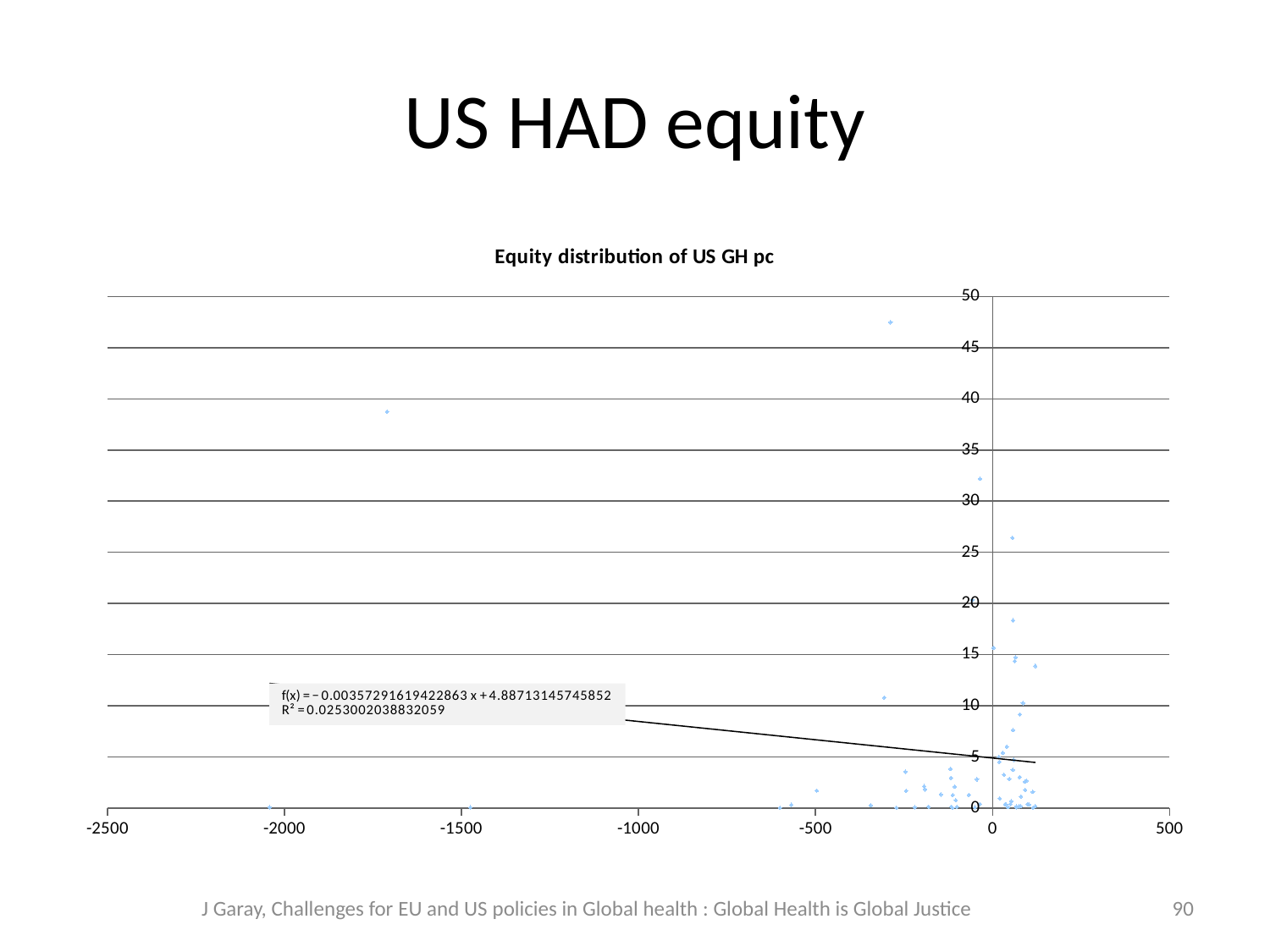
Is the y value of the point plotted near x = -500 greater or less than 5? less Is the y value of the highest plotted point greater or less than 45? greater What is the title of the chart? Equity distribution of US GH pc Does the fitted trendline rise or fall as x increases? fall Is the y value of the point plotted near x = -1700 greater or less than 35? greater What is the R² value shown for the trendline? 0.0253002038832059 What kind of chart is shown on the slide? scatter chart What is the lowest value shown on the x axis? -2500